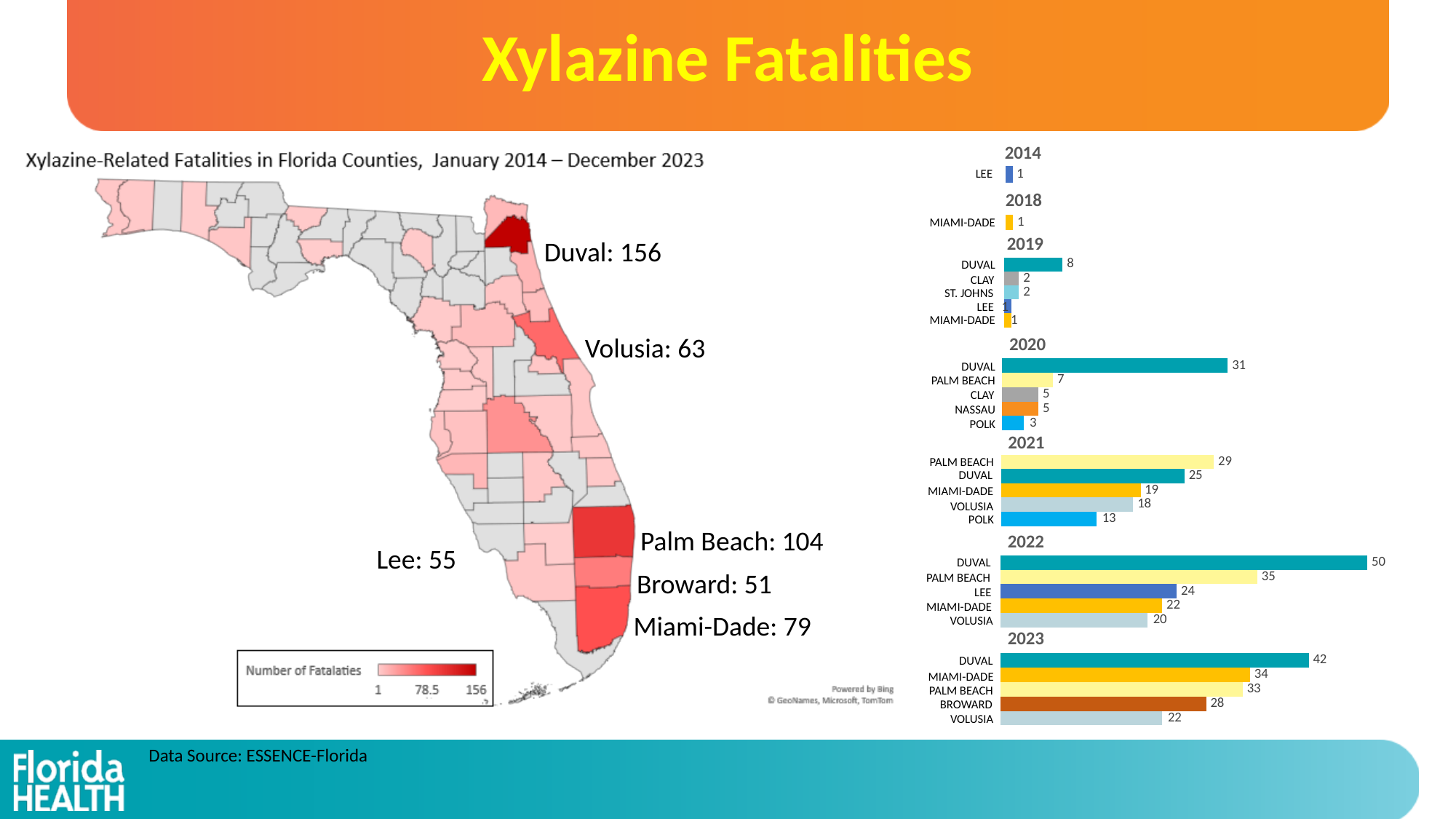
In the bar chart on the right, how many counties are listed for 2019? 5 In the bar chart on the right, what is the value for Palm Beach in 2021? 29 In the bar chart on the right, which county has the lowest value in 2020? Polk In the bar chart on the right, which is larger in 2023: Miami-Dade or Palm Beach? Miami-Dade On the map on the left, what is the difference between the labeled values for Palm Beach and Miami-Dade? 25 What kind of chart is shown on the right side of the slide? Bar chart On the map on the left, what is the number of fatalities labeled for Duval? 156 In the bar chart on the right, what is the difference between Duval and Palm Beach in 2022? 15 In the bar chart on the right, what is the value for Duval in 2022? 50 In the bar chart on the right, which county has the highest value in 2023? Duval On the map on the left, what is the number of fatalities labeled for Broward? 51 What is the title of the map on the left? Xylazine-Related Fatalities in Florida Counties, January 2014 – December 2023